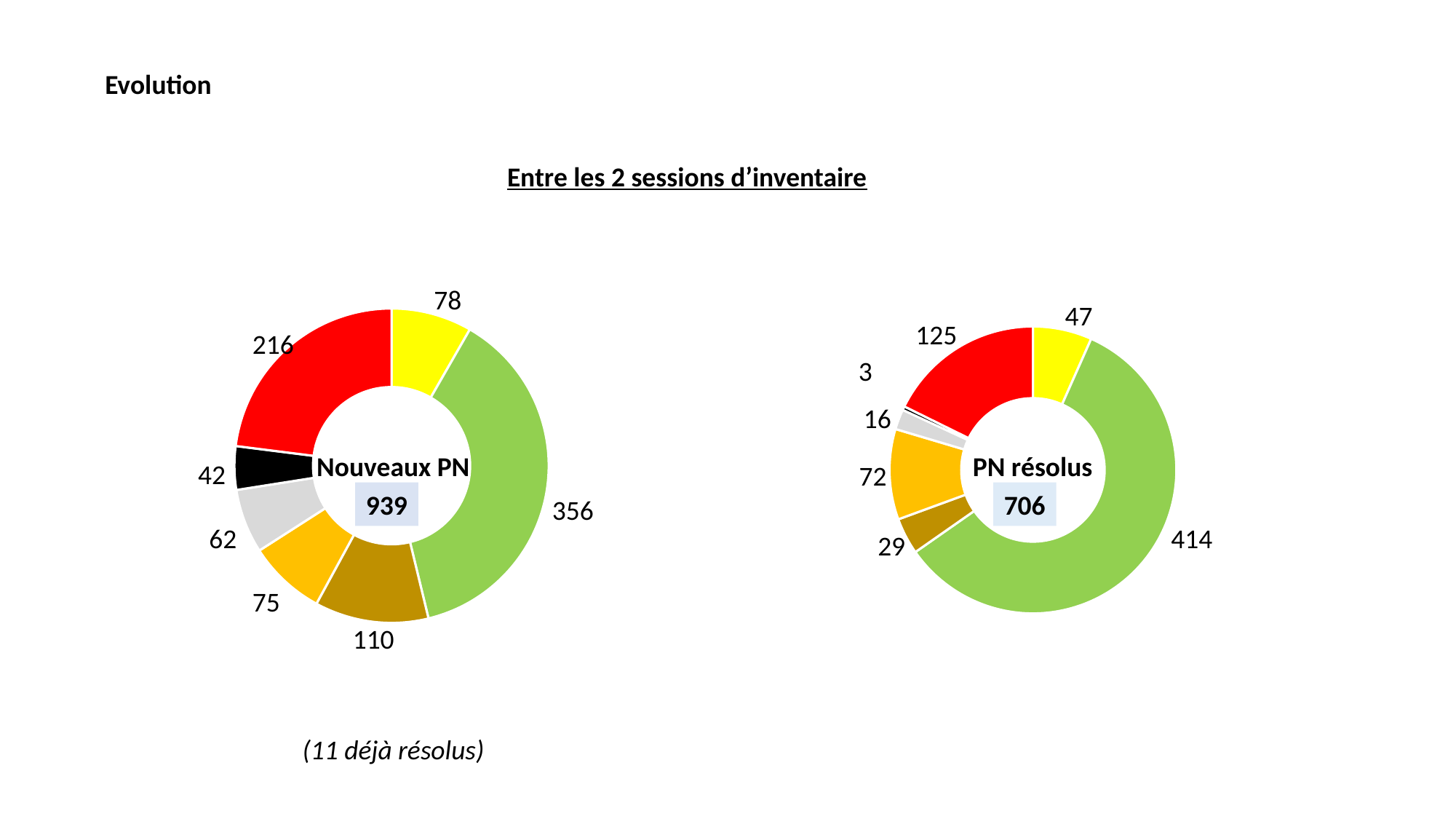
What is the title written above the two charts? Entre les 2 sessions d'inventaire How many slices does the "PN résolus" chart have? 7 What kind of chart is used for "Nouveaux PN"? doughnut (pie) chart In the "Nouveaux PN" chart, which slice has the largest value? the green slice (356) What total is printed in the centre of the "PN résolus" chart? 706 In the "PN résolus" chart, which slice has the smallest value? the black slice (3) In the "PN résolus" chart, what value is shown for the red slice? 125 In the "Nouveaux PN" chart, what value is shown for the green slice? 356 In the "Nouveaux PN" chart, what value is shown for the black slice? 42 What is the difference between the green slice values of the "PN résolus" chart (414) and the "Nouveaux PN" chart (356)? 58 In the "Nouveaux PN" chart, which is larger: the red slice or the yellow slice? the red slice (216) What is the total of all slices in the "Nouveaux PN" chart? 939